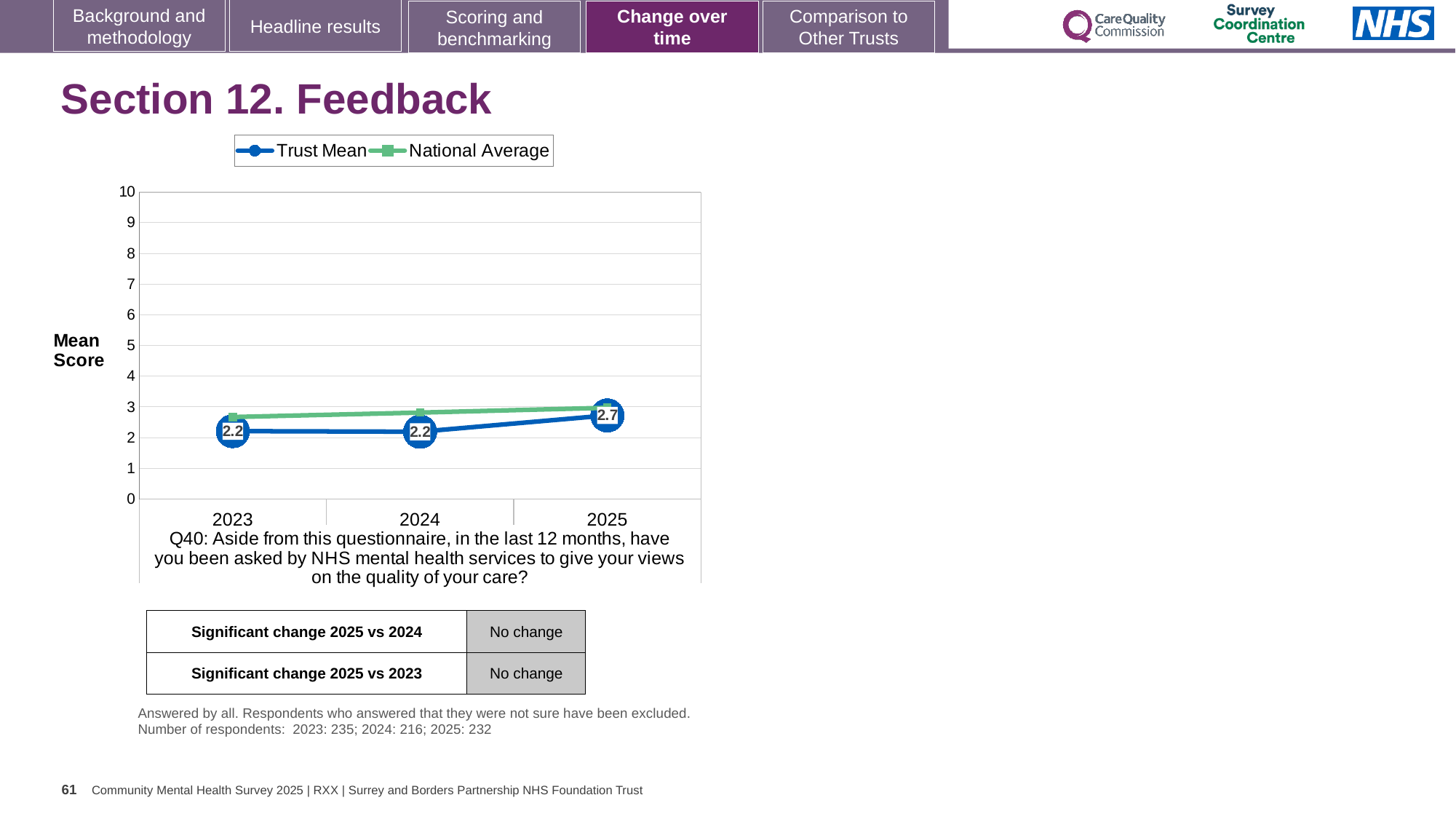
What kind of chart is shown on the slide? Line chart Is the National Average value for 2024 greater or less than 3? less How many years are plotted on the x axis? 3 What is the Trust Mean score for 2024? 2.2 Does the Trust Mean rise or fall from 2024 to 2025? Rise How many series does the legend list? 2 What is the Trust Mean score for 2023? 2.2 Is the National Average value for 2023 greater or less than 2? greater In 2023, which is larger: the Trust Mean or the National Average? National Average What is the difference between the Trust Mean score in 2025 and in 2023? 0.5 What is the Trust Mean score for 2025? 2.7 In which year is the Trust Mean score highest? 2025